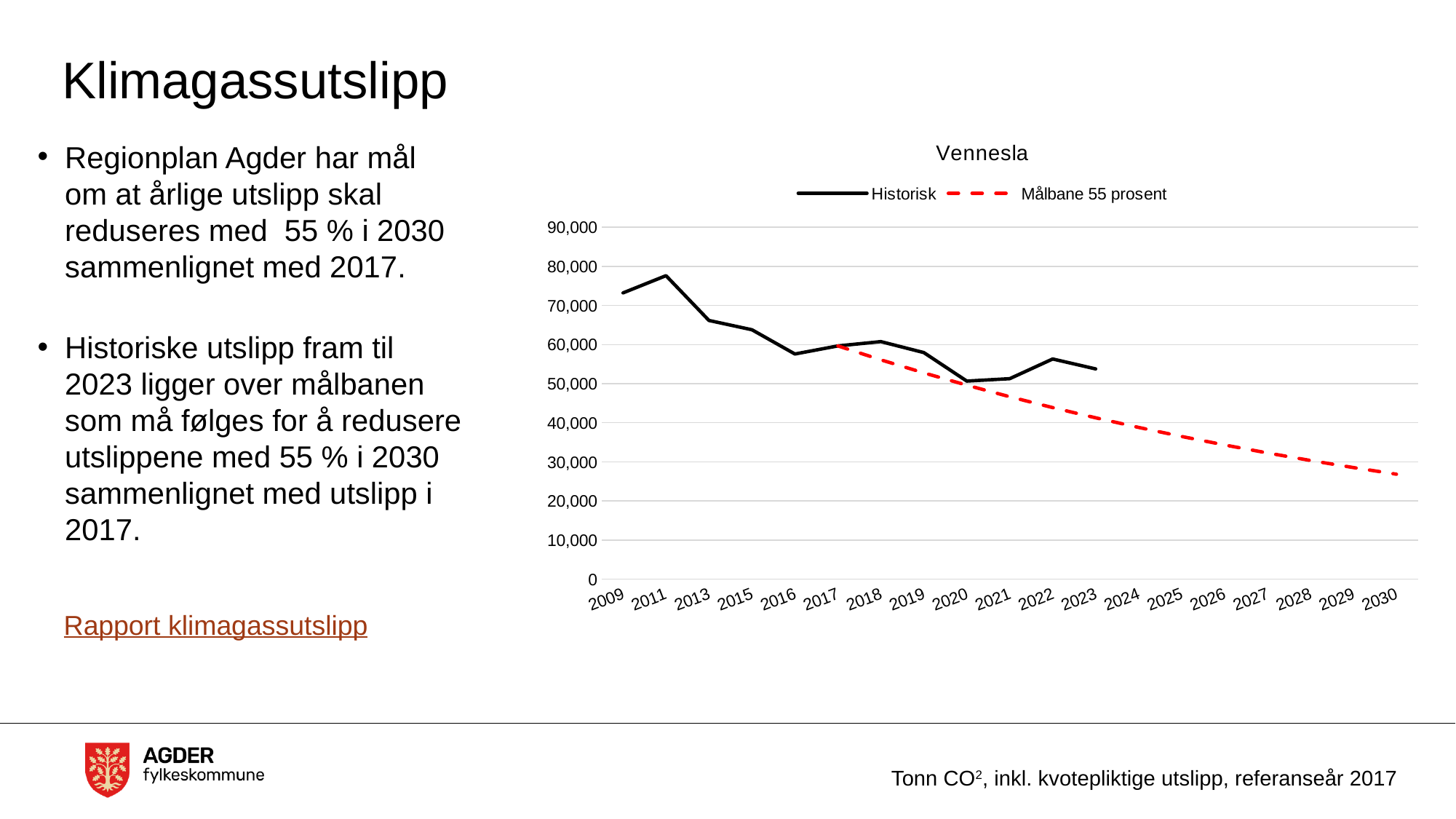
Which is larger, the Historisk value for 2011 or for 2013? 2011 Is the Historisk value for 2011 greater or less than 70,000? greater What is the title of the chart? Vennesla Which series is drawn as a red dashed line? Målbane 55 prosent Does the Målbane 55 prosent series rise or fall from 2017 to 2030? fall What kind of chart is shown on the slide? line chart Is the Målbane 55 prosent value for 2030 greater or less than 30,000? less How many years are labelled on the x axis of the chart? 19 In which year does the Historisk series reach its highest value? 2011 Is the Historisk value for 2022 greater or less than 50,000? greater How many series does the chart legend list? 2